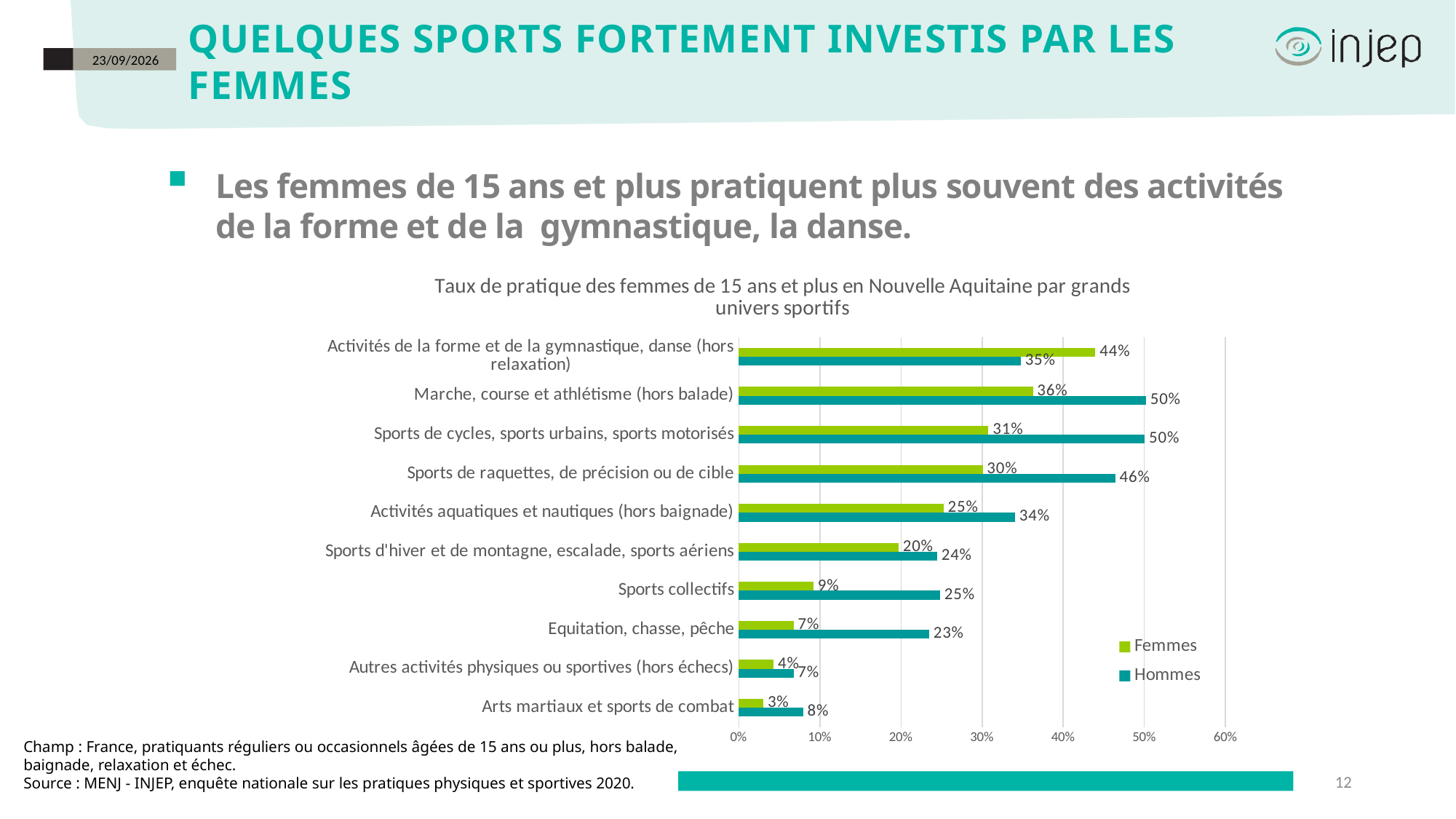
Which category has the lowest Hommes value? Autres activités physiques ou sportives (hors échecs) What is the Femmes value for "Sports collectifs"? 9% For "Marche, course et athlétisme (hors balade)", which is larger, the Femmes value or the Hommes value? Hommes What is the Hommes value for "Sports de raquettes, de précision ou de cible"? 46% What is the difference between the Hommes and Femmes values for "Equitation, chasse, pêche"? 16% Which category has the highest Femmes value? Activités de la forme et de la gymnastique, danse (hors relaxation) What kind of chart is shown on the slide? Bar chart Which colour represents the Femmes series in the chart? Green What is the Femmes value for "Activités de la forme et de la gymnastique, danse (hors relaxation)"? 44% Is the Hommes value for "Activités aquatiques et nautiques (hors baignade)" greater or less than 30%? greater How many categories are shown on the chart? 10 How many series does the legend list? 2